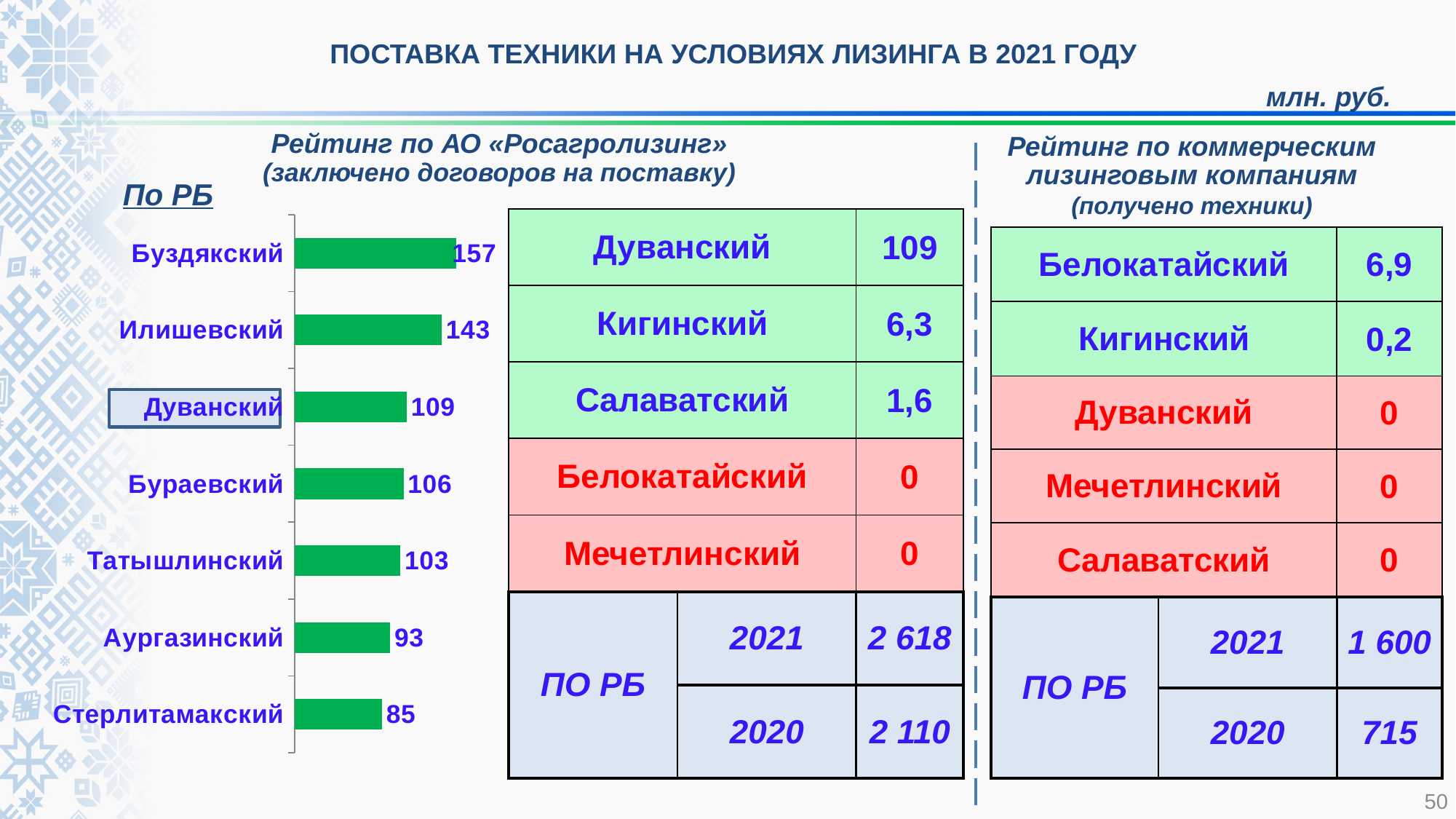
Do the values in the bar chart rise or fall from the top category to the bottom category? Fall What is the value for Татышлинский in the bar chart? 103 What is the value for Буздякский in the bar chart? 157 Which category has the lowest value in the bar chart? Стерлитамакский Which is larger in the bar chart, the value for Бураевский or the value for Аургазинский? Бураевский What is the value for Аургазинский in the bar chart? 93 Which category has the highest value in the bar chart? Буздякский How many categories are shown in the bar chart? 7 What kind of chart is shown on the left of the slide? Bar chart What is the difference between the values for Буздякский and Илишевский in the bar chart? 14 What colour are the bars in the bar chart? Green What is the difference between the values for Дуванский and Стерлитамакский in the bar chart? 24